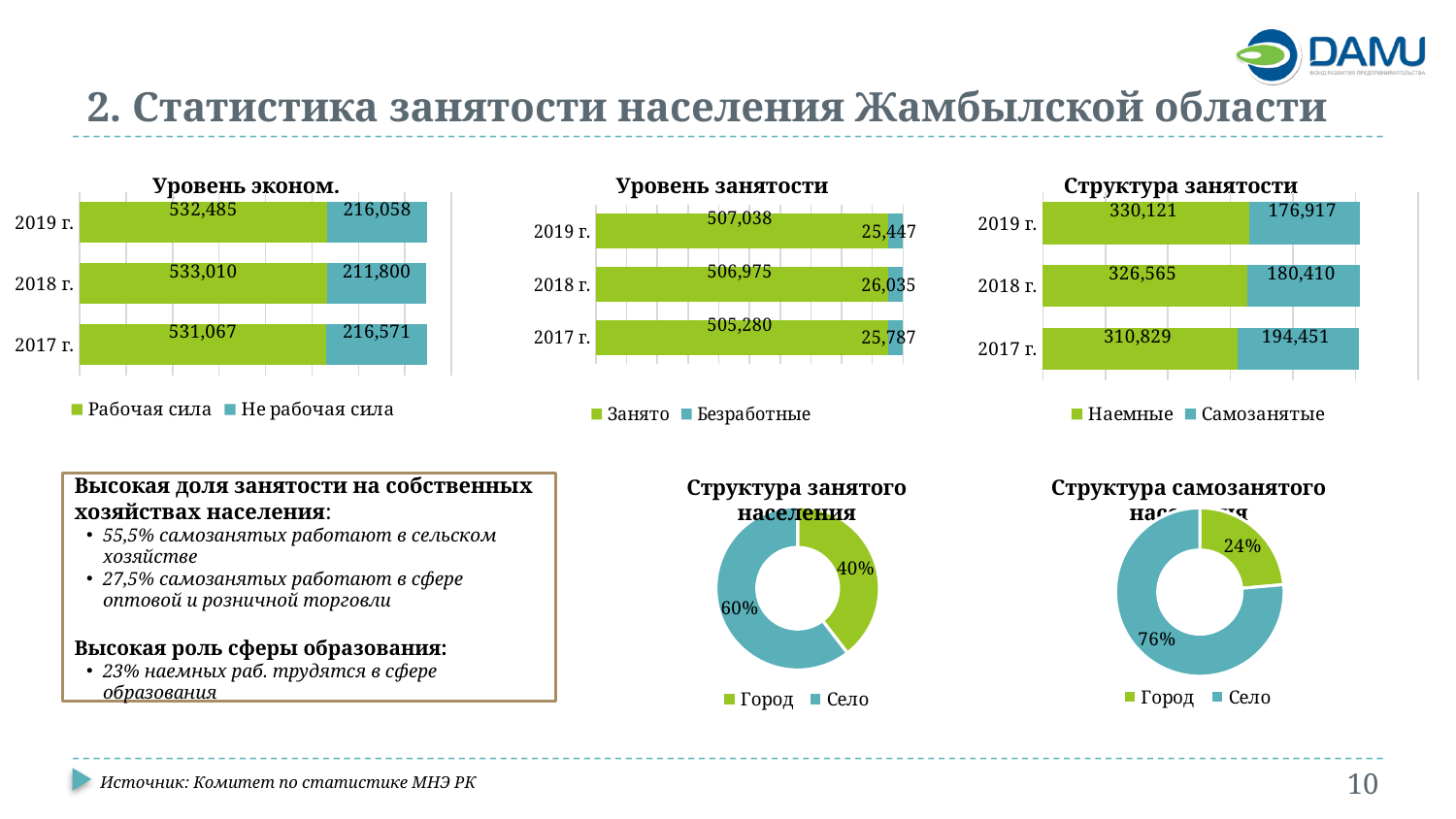
How many series does the legend of the chart titled "Уровень эконом." list? 2 In the chart titled "Структура самозанятого населения", what is the value for Город? 24% In the chart titled "Уровень эконом.", what is the value for Рабочая сила in 2019 г.? 532,485 In the chart titled "Структура занятости", what is the value for Самозанятые in 2017 г.? 194,451 In the chart titled "Уровень эконом.", what is the total of the stacked bar for 2018 г.? 744,810 In the chart titled "Структура занятости", what is the difference between Наемные and Самозанятые in 2019 г.? 153,204 In the chart titled "Структура занятости", which year has the highest value for Наемные? 2019 г. In the chart titled "Уровень занятости", what is the value for Безработные in 2018 г.? 26,035 In the chart titled "Уровень занятости", which year has the lowest value for Безработные? 2019 г. In the chart titled "Структура занятого населения", what share does Село have? 60% What kind of chart is the one titled "Структура занятости"? Bar chart In the chart titled "Уровень эконом.", which year has the larger value for Не рабочая сила, 2017 г. or 2018 г.? 2017 г.